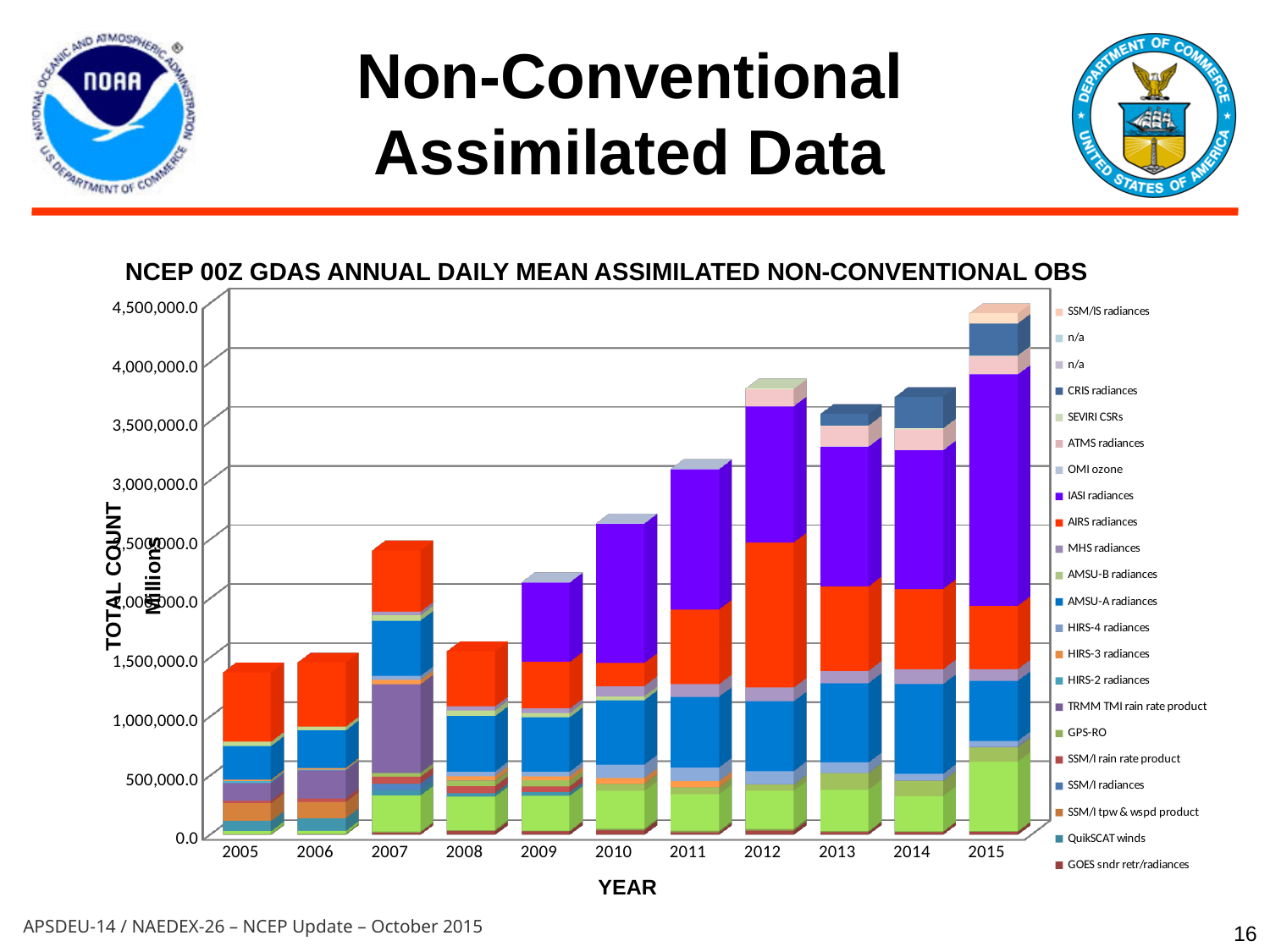
Which year has the highest total count in the chart? 2015 Which year has a larger total count, 2007 or 2008? 2007 Which year has the lowest total count in the chart? 2005 Is the total count for 2015 greater or less than 4,000,000.0? greater Is the total count for 2007 greater or less than 2,500,000.0? less What kind of chart is shown on the slide? Stacked bar chart Is the total count for 2012 greater or less than 3,500,000.0? greater How many years are shown along the x axis of the chart? 11 What is the title of the chart? NCEP 00Z GDAS ANNUAL DAILY MEAN ASSIMILATED NON-CONVENTIONAL OBS Does the total count generally rise or fall from 2005 to 2015? Rise Which year has a larger total count, 2009 or 2010? 2010